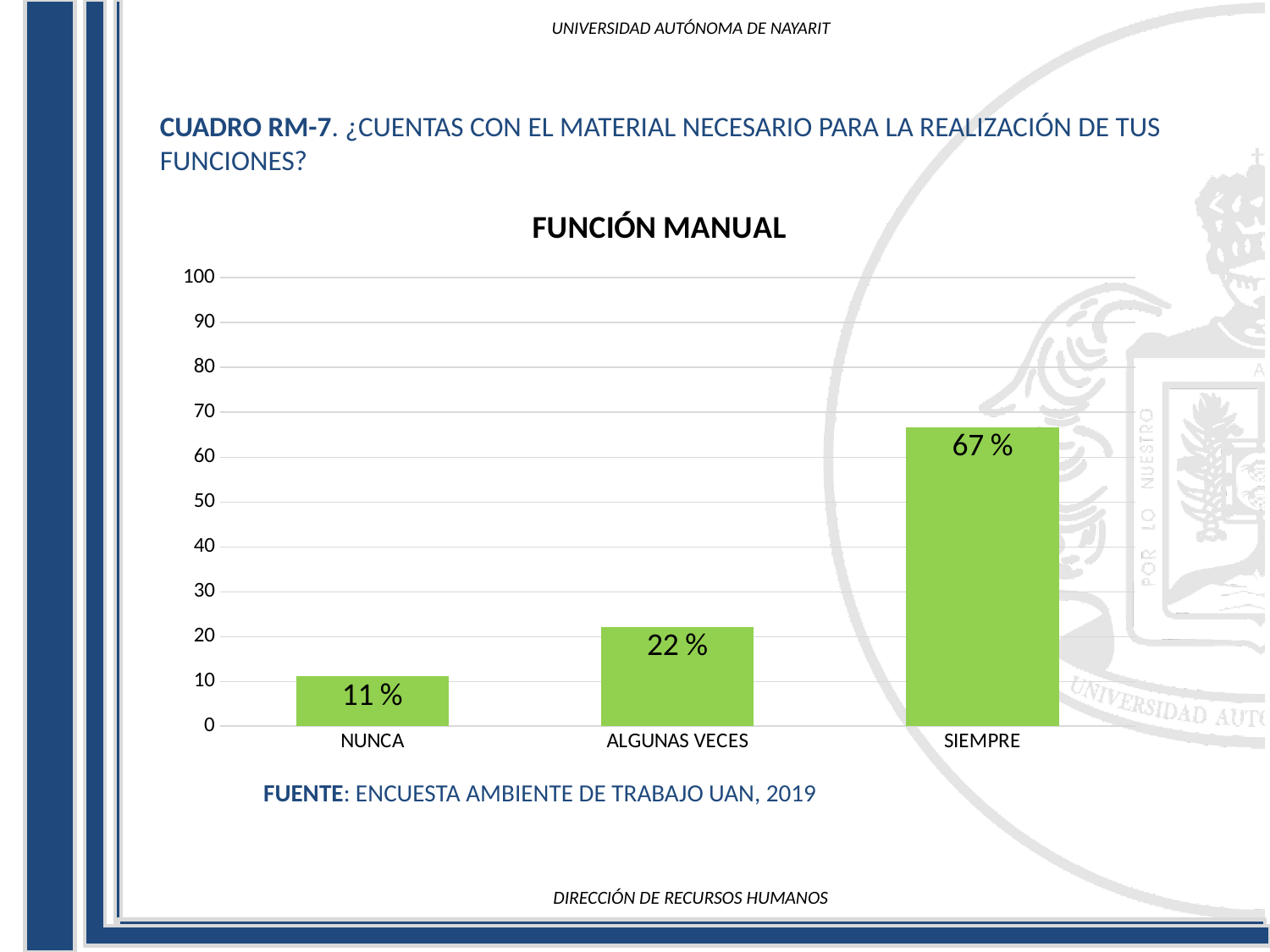
What is the difference between the values for ALGUNAS VECES and NUNCA? 11 % What is the difference between the values for SIEMPRE and ALGUNAS VECES? 45 % Which category has the highest value? SIEMPRE What is the title of the chart? FUNCIÓN MANUAL Which is larger, the value for ALGUNAS VECES or the value for NUNCA? ALGUNAS VECES What is the value for ALGUNAS VECES? 22 % What kind of chart is shown on the slide? bar chart Is the value for SIEMPRE greater or less than 50? greater Which category has the lowest value? NUNCA What is the value for NUNCA? 11 % How many categories are shown on the x axis? 3 What is the value for SIEMPRE? 67 %